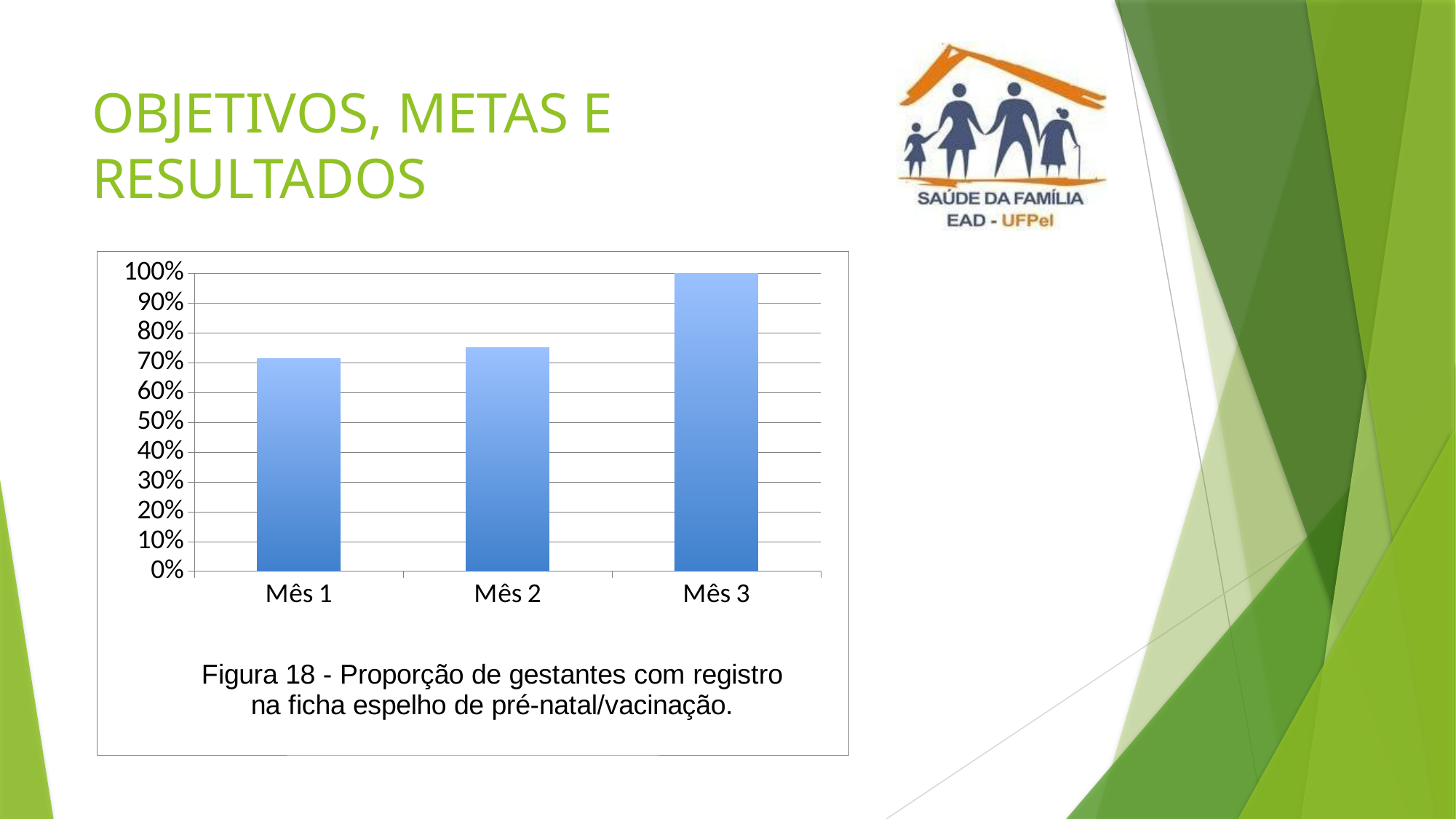
What is the figure number given in the chart caption? Figura 18 Which is larger, the value for Mês 1 or the value for Mês 2? Mês 2 What kind of chart is shown on the slide? bar chart Is the value for Mês 2 greater or less than 80%? less How many categories (months) are plotted in the chart? 3 Which month has the lowest proportion in the chart? Mês 1 Do the values rise or fall from Mês 1 to Mês 3? rise What is the maximum value shown on the vertical axis? 100% Is the value for Mês 2 greater or less than 70%? greater Which month has the highest proportion in the chart? Mês 3 What is the value for Mês 3? 100% Is the value for Mês 1 greater or less than 80%? less